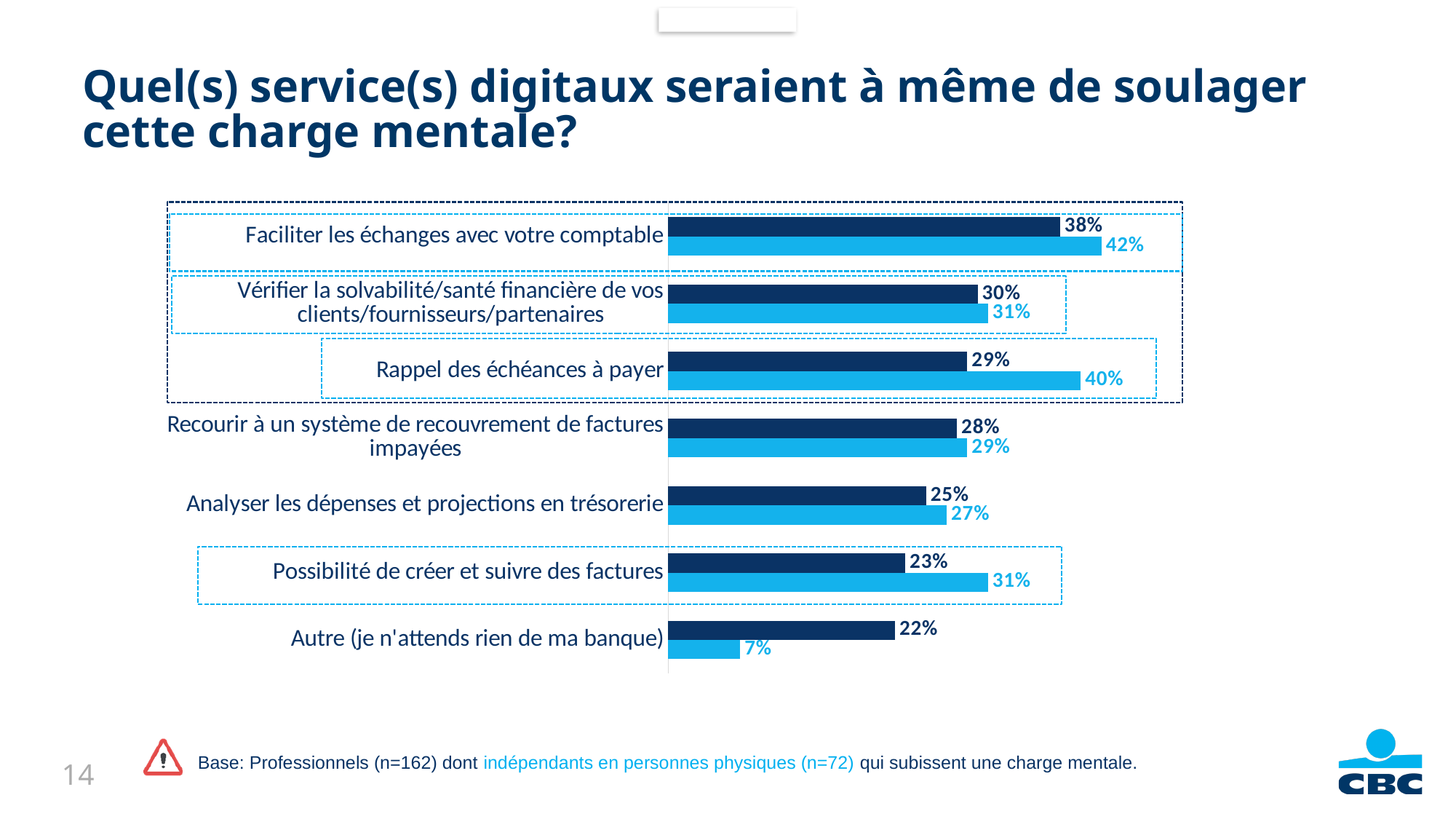
What is the difference between the light blue and dark blue values for 'Rappel des échéances à payer'? 11% Which category has the lowest light blue bar value? Autre (je n'attends rien de ma banque) What is the value of the dark blue bar for 'Possibilité de créer et suivre des factures'? 23% What is the value of the dark blue bar for 'Faciliter les échanges avec votre comptable'? 38% What is the value of the light blue bar for 'Rappel des échéances à payer'? 40% How many categories are shown in the chart? 7 For 'Autre (je n'attends rien de ma banque)', which bar is larger, the dark blue or the light blue? dark blue What is the value of the light blue bar for 'Autre (je n'attends rien de ma banque)'? 7% What is the difference between the dark blue values for 'Faciliter les échanges avec votre comptable' and 'Autre (je n'attends rien de ma banque)'? 16% How many bars are shown for each category? 2 What type of chart is shown on the slide? bar chart Which category has the highest light blue bar value? Faciliter les échanges avec votre comptable